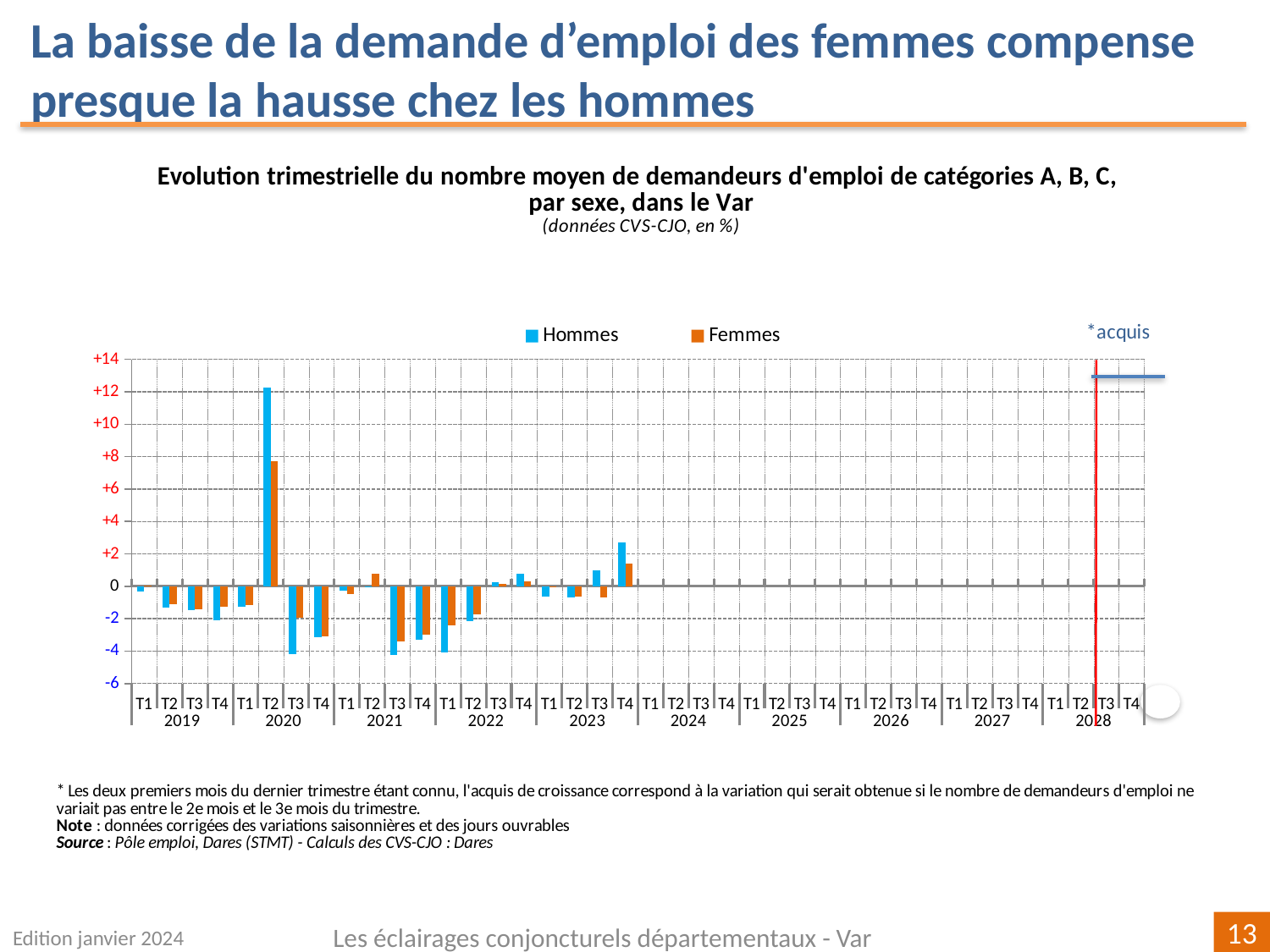
In which quarter does the Femmes series reach its highest value? T2 2020 Does the Hommes series rise or fall from T1 2023 to T4 2023? rise Is the Hommes value for T3 2020 greater or less than -2? less How many series does the chart legend list? 2 In T4 2023, which series has the larger value, Hommes or Femmes? Hommes In which quarter does the Hommes series reach its highest value? T2 2020 Is the Hommes value for T2 2020 greater or less than +10? greater What kind of chart is shown on the slide? bar chart In T2 2020, which series has the larger value, Hommes or Femmes? Hommes What are the two series named in the chart legend? Hommes and Femmes Is the Hommes value for T4 2023 greater or less than +2? greater